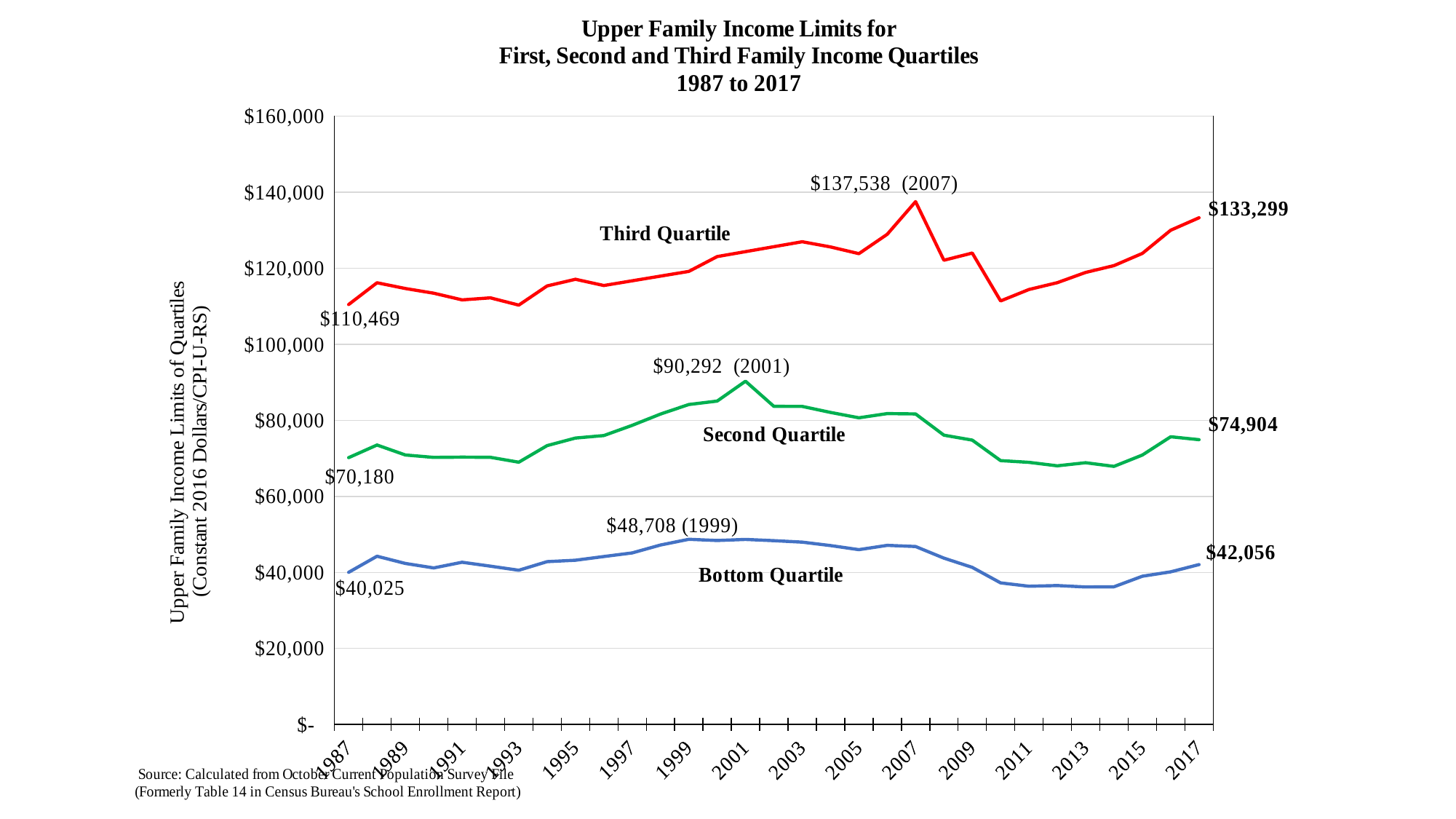
Is the Bottom Quartile value in 2013 greater or less than $40,000? less What is the difference between the Bottom Quartile peak in 1999 and its 1987 value? $8,683 What is the Second Quartile upper income limit in 1987? $70,180 Which is larger: the Second Quartile value in 2017 or its value in 1987? 2017 ($74,904) In which year did the Third Quartile reach its labeled peak of $137,538? 2007 What is the difference between the Third Quartile value in 2017 and its value in 1987? $22,830 What is the Third Quartile upper income limit in 2017? $133,299 What is the Bottom Quartile upper income limit in 2017? $42,056 How many series (quartile lines) are plotted on the chart? 3 What kind of chart is shown on the slide? line chart What was the peak value of the Second Quartile, labeled in 2001? $90,292 Is the Third Quartile value in 2010 greater or less than $120,000? less